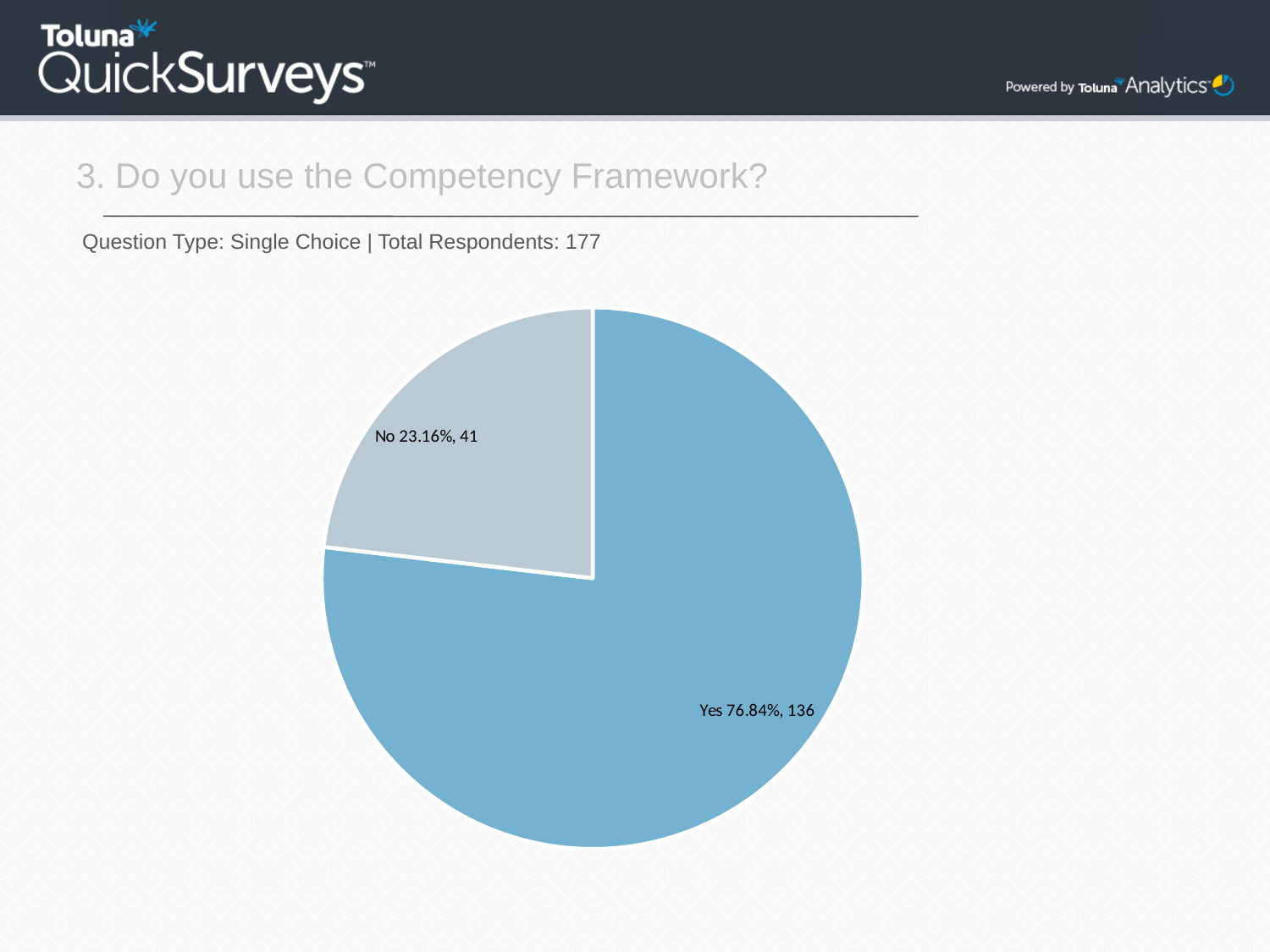
Which response has the smallest share of the pie? No What kind of chart is shown on the slide? pie chart What is the question title shown above the chart? 3. Do you use the Competency Framework? How many respondents answered Yes? 136 What is the total number of respondents shown on the slide? 177 What is the difference in respondent count between Yes and No? 95 What percentage of respondents answered Yes? 76.84% What percentage of respondents answered No? 23.16% How many slices does the pie chart have? 2 Which is larger, the share for Yes or the share for No? Yes How many respondents answered No? 41 Which response has the largest share of the pie? Yes